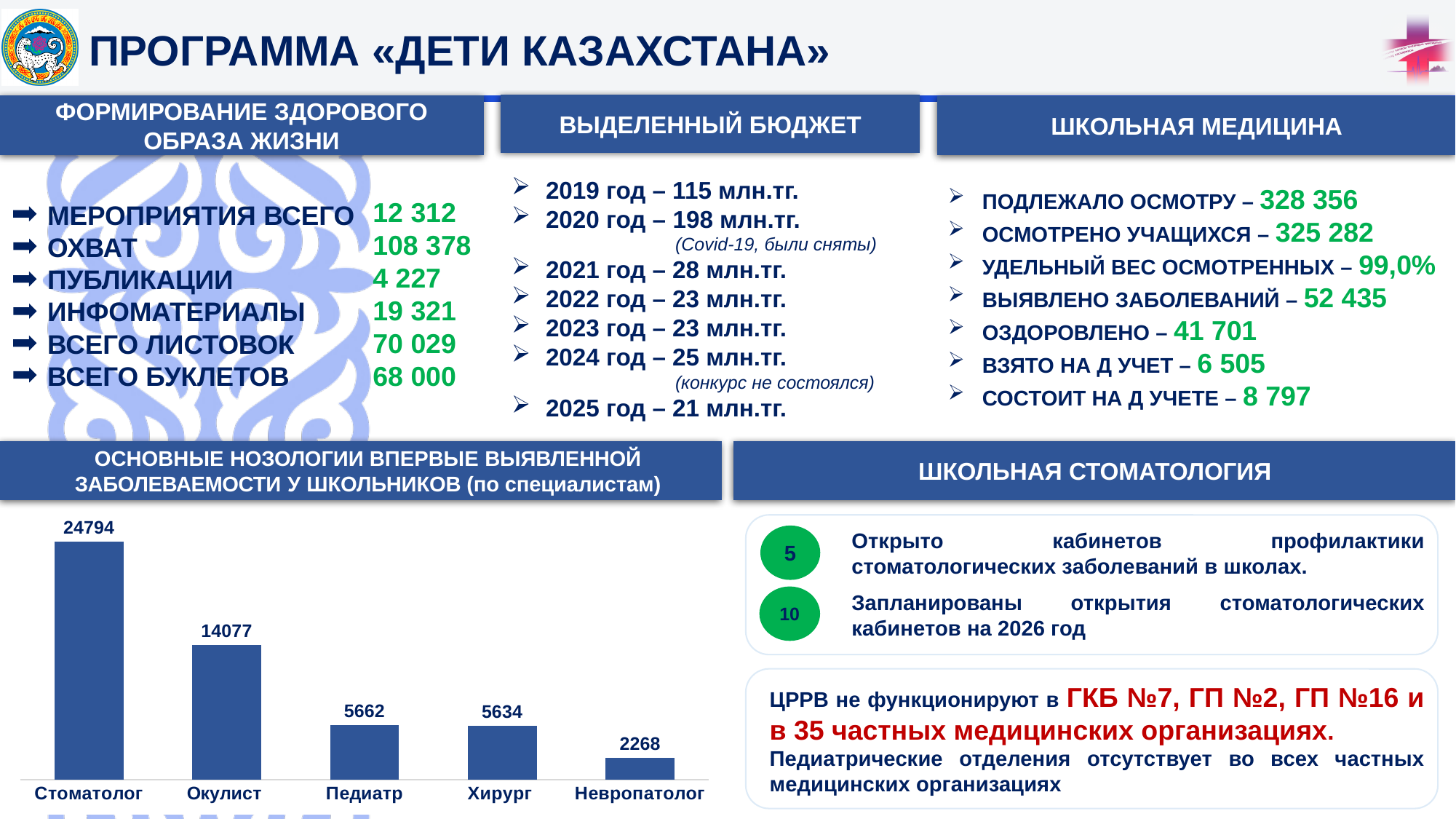
What is the difference between the values for Стоматолог and Окулист in the bar chart? 10717 What value is shown for Педиатр in the bar chart? 5662 What type of chart is used to show the nosologies by specialist? Bar chart What is the difference between the values for Педиатр and Хирург in the bar chart? 28 What value is shown for Невропатолог in the bar chart? 2268 In the bar chart, which is larger: the value for Окулист or the value for Хирург? Окулист Which specialist category has the highest value in the bar chart? Стоматолог What value is shown for Стоматолог in the bar chart? 24794 How many specialist categories are shown in the bar chart? 5 What value is shown for Окулист in the bar chart? 14077 Do the values in the bar chart rise or fall from left to right across the categories? Fall Which specialist category has the lowest value in the bar chart? Невропатолог